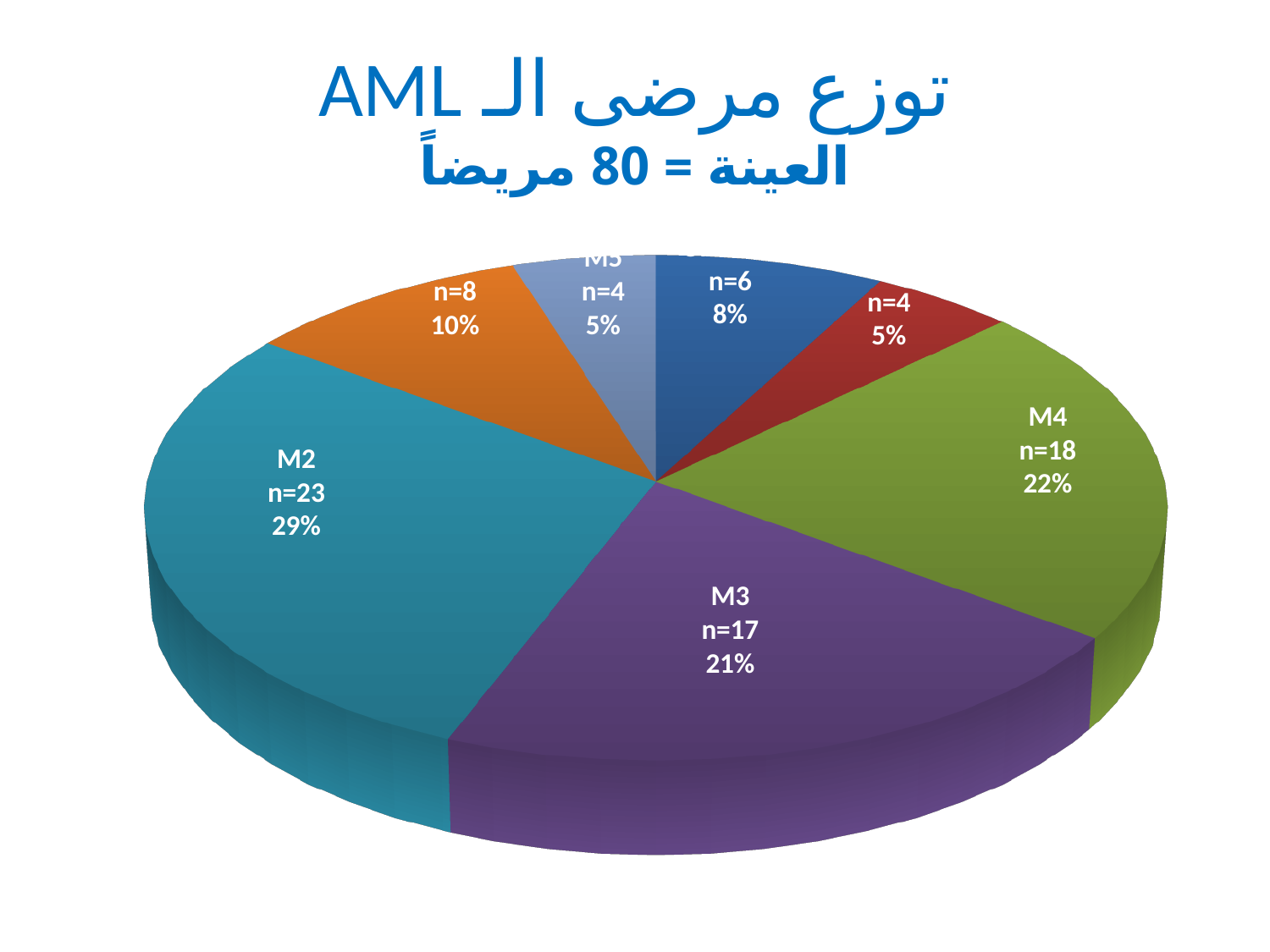
What kind of chart is shown on the slide? pie chart What is the difference in number of patients between M2 and M3? 6 Which slice is larger, M3 or M4? M4 How many patients (n) are in the M4 slice? n=18 Which labelled category has the largest slice of the pie? M2 What is the difference in percentage between the M4 and M3 slices? 1% How many patients (n) are in the M2 slice? n=23 What percentage of the pie does the M5 slice represent? 5% According to the subtitle, what is the total sample size? 80 What percentage of the pie does the M2 slice represent? 29% How many slices does the pie chart have? 7 What percentage of the pie does the M3 slice represent? 21%